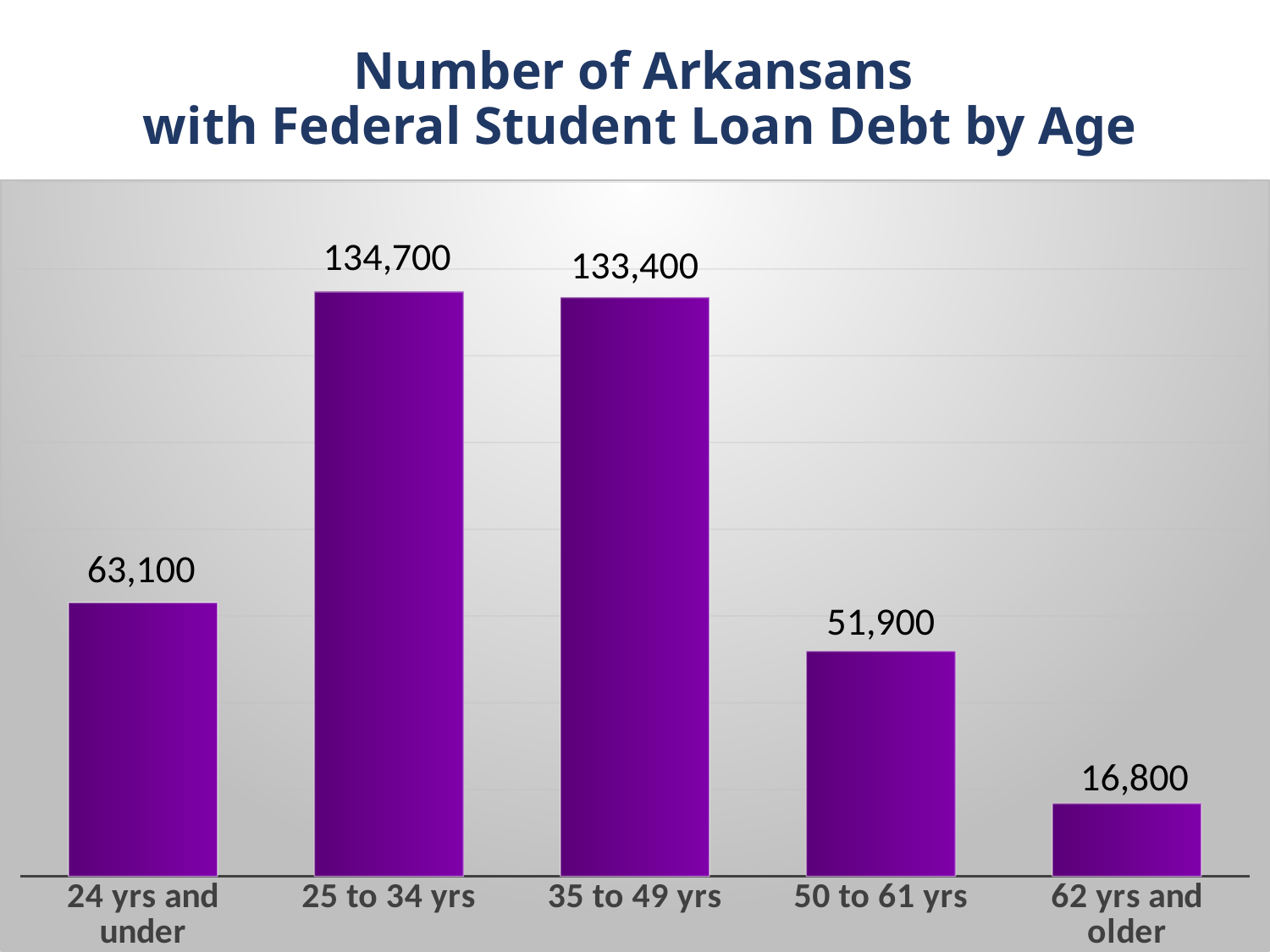
Which age group has the lowest number of Arkansans with federal student loan debt? 62 yrs and older Which age group has the highest number of Arkansans with federal student loan debt? 25 to 34 yrs What is the value for the 25 to 34 yrs age group? 134,700 What kind of chart is shown on the slide? Bar chart Which is larger, the value for 24 yrs and under or the value for 50 to 61 yrs? 24 yrs and under What is the number of Arkansans with federal student loan debt aged 24 yrs and under? 63,100 What is the difference between the values for 24 yrs and under and 62 yrs and older? 46,300 What is the value for the 50 to 61 yrs age group? 51,900 How many age groups are shown in the chart? 5 What is the value for the 35 to 49 yrs age group? 133,400 What is the difference between the values for 25 to 34 yrs and 35 to 49 yrs? 1,300 What is the value for the 62 yrs and older age group? 16,800